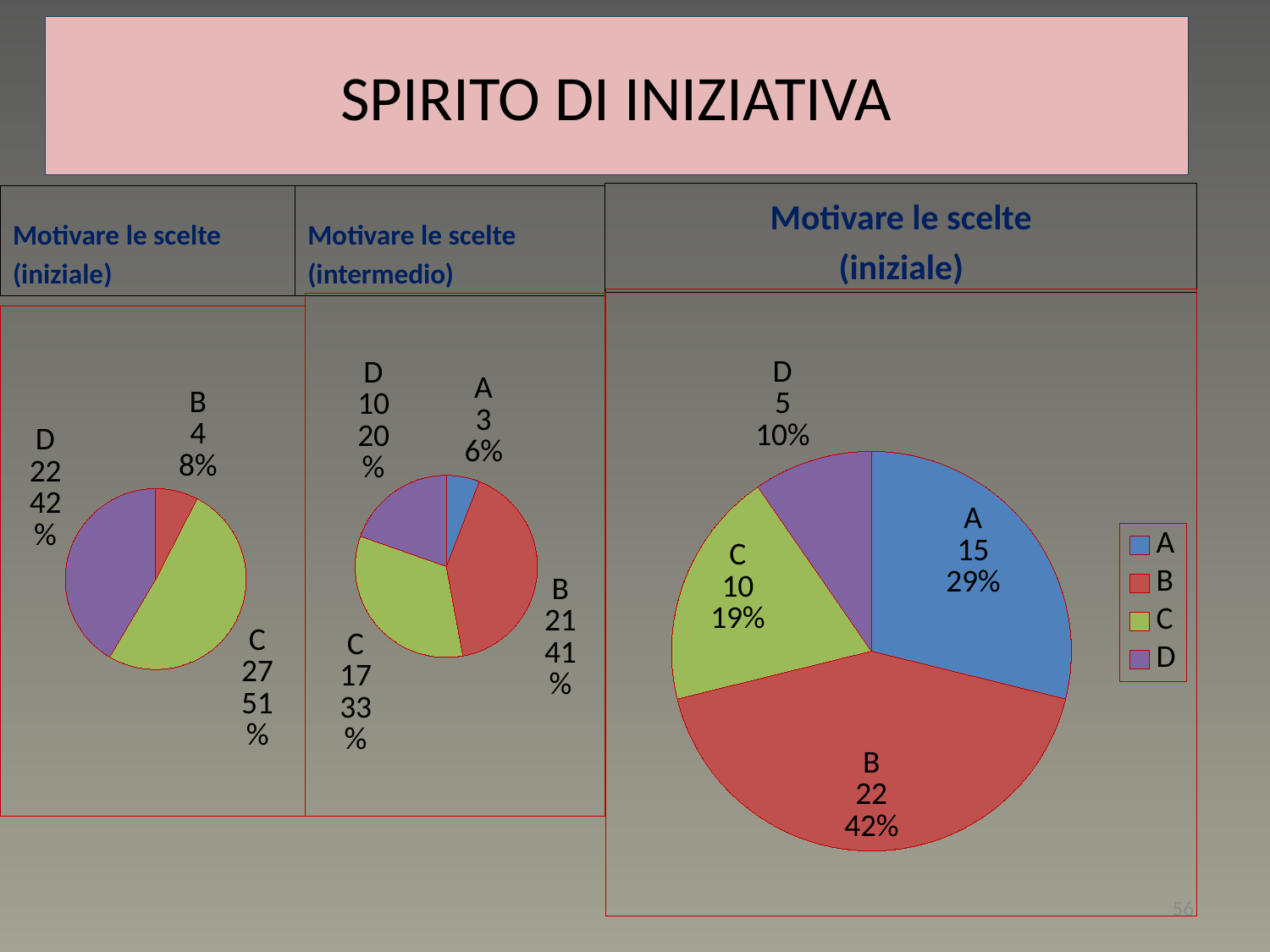
In the middle pie chart titled 'Motivare le scelte (intermedio)', what percentage does category D have? 20% What type of chart is used on this slide? Pie chart In the large pie chart on the right, what is the difference between the values for A and D? 10 In the large pie chart on the right, which category has the largest slice? B In the middle pie chart titled 'Motivare le scelte (intermedio)', which category has the smallest slice? A In the large pie chart on the right, what is the value for category B? 22 In the large pie chart on the right, which category has the smallest slice? D In the middle pie chart titled 'Motivare le scelte (intermedio)', what is the value for category B? 21 In the small pie chart on the left titled 'Motivare le scelte (iniziale)', what is the value for category C? 27 In the large pie chart on the right, what share of the pie does category C have? 19% In the small pie chart on the left titled 'Motivare le scelte (iniziale)', how many categories are shown? 3 How many entries does the legend of the large pie chart on the right list? 4